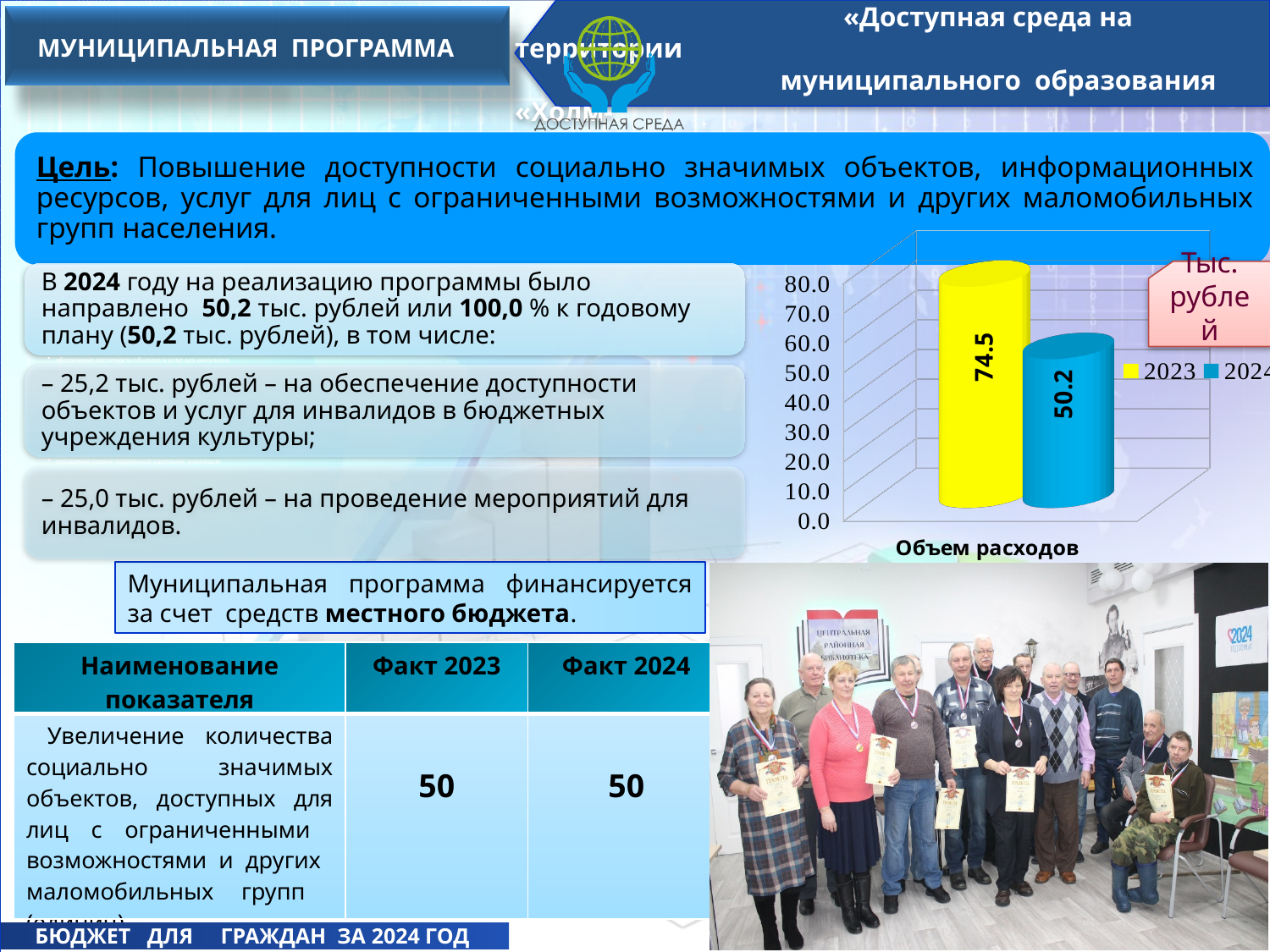
Is the value for 2024 greater or less than 60.0? less Which series has the lowest value in the chart? 2024 How many series does the chart legend list? 2 Is the value for 2023 greater or less than 70.0? greater What colour is the bar for 2023 in the chart? yellow What is the difference between the 2023 and 2024 values in the chart? 24.3 What is the highest value shown on the chart's vertical axis? 80.0 What kind of chart is shown on the slide? bar chart What is the category label shown under the bars in the chart? Объем расходов What is the value for 2024 in the chart? 50.2 What is the value for 2023 in the chart? 74.5 Which year has the higher value in the chart, 2023 or 2024? 2023